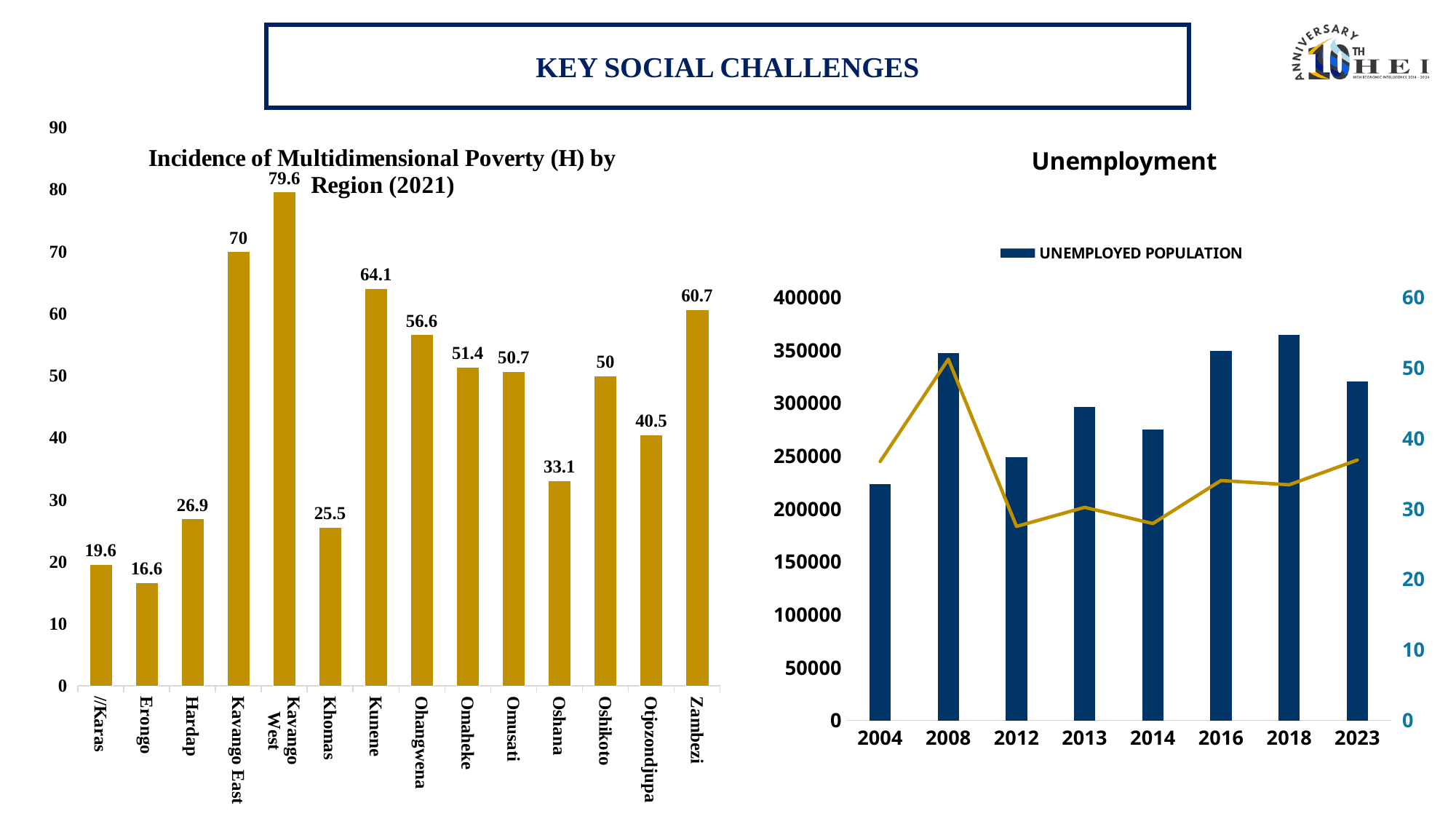
In the Incidence of Multidimensional Poverty chart, what is the value for Oshana? 33.1 How many regions are shown in the Incidence of Multidimensional Poverty chart? 14 In the Incidence of Multidimensional Poverty chart, which region has the highest value? Kavango West What kind of chart is the Incidence of Multidimensional Poverty chart? Bar chart In the Incidence of Multidimensional Poverty chart, which is larger, Zambezi or Ohangwena? Zambezi In the Unemployment chart, is the unemployed population bar for 2018 greater or less than 350000? greater How many series does the legend of the Unemployment chart list? 1 In the Unemployment chart, which year has the highest unemployed population bar? 2018 In the Incidence of Multidimensional Poverty chart, what is the value for Kavango West? 79.6 In the Incidence of Multidimensional Poverty chart, what is the difference between Kavango East and Khomas? 44.5 In the Unemployment chart, is the unemployed population bar for 2004 greater or less than 250000? less In the Incidence of Multidimensional Poverty chart, which region has the lowest value? Erongo